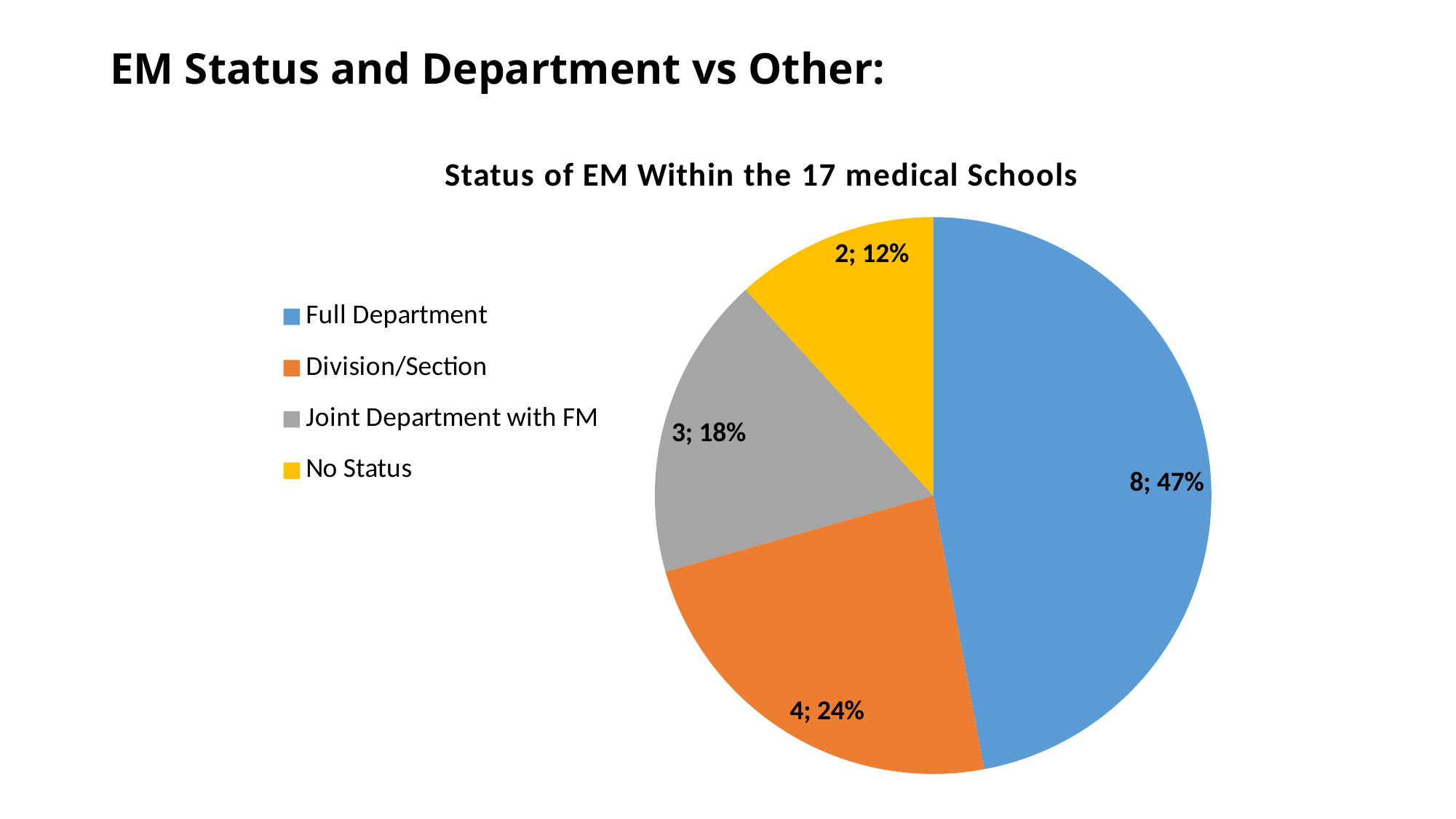
What is the count for Joint Department with FM? 3 What is the title of the chart? Status of EM Within the 17 medical Schools What colour is the Full Department slice? blue How many medical schools have EM as a Full Department? 8 Which category has the smallest slice? No Status What percentage share does No Status have? 12% What percentage share does Division/Section have? 24% Which is larger, Joint Department with FM or No Status? Joint Department with FM What is the difference in count between Full Department and Division/Section? 4 What kind of chart is shown on the slide? pie chart Which category has the largest slice? Full Department How many categories does the pie chart have? 4